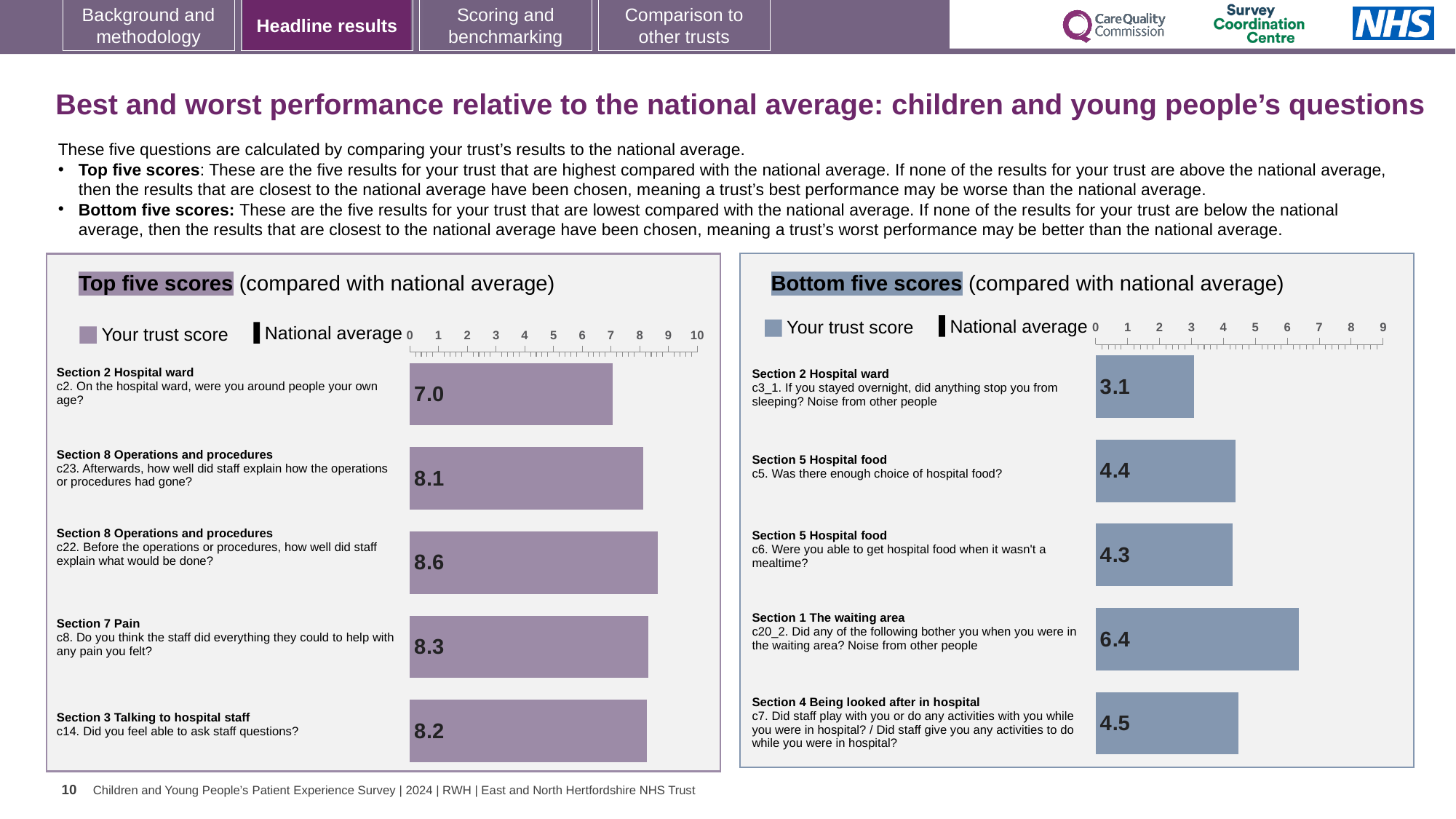
How many questions are plotted in the Bottom five scores chart? 5 In the Top five scores chart, which question has the highest trust score? c22. Before the operations or procedures, how well did staff explain what would be done? In the Top five scores chart, is the trust score for c8 (pain) greater or less than 8? greater In the Top five scores chart, what is the trust score for c2 (On the hospital ward, were you around people your own age?)? 7.0 In the Top five scores chart, what is the trust score for c14 (Did you feel able to ask staff questions?)? 8.2 In the Top five scores chart, what is the difference between the trust scores for c22 and c2? 1.6 In the Bottom five scores chart, which question has the lowest trust score? c3_1. If you stayed overnight, did anything stop you from sleeping? Noise from other people In the Bottom five scores chart, which has the higher trust score: c5 (enough choice of hospital food) or c6 (food when it wasn't a mealtime)? c5 What type of chart is the Top five scores chart? Bar chart What is the maximum value shown on the axis of the Top five scores chart? 10 In the Bottom five scores chart, what is the trust score for c20_2 (noise from other people in the waiting area)? 6.4 In the Bottom five scores chart, what is the difference between the trust scores for c20_2 and c3_1? 3.3